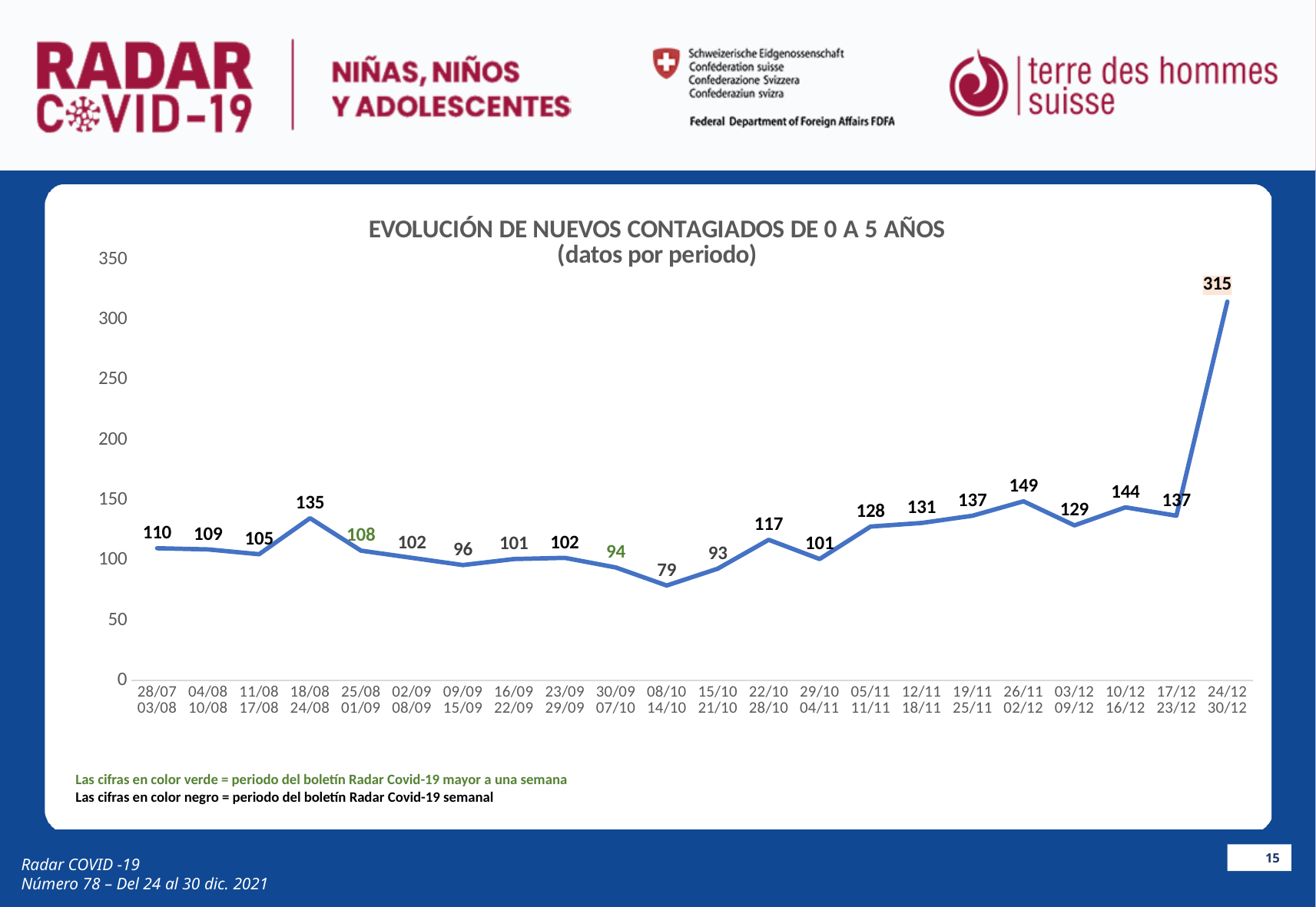
What is the value for the period 26/11–02/12? 149 What is the value for the period 24/12–30/12? 315 What is the title of the chart? EVOLUCIÓN DE NUEVOS CONTAGIADOS DE 0 A 5 AÑOS (datos por periodo) Which period has the lowest value? 08/10–14/10 How many periods are plotted on the x axis? 22 Which values are shown in green on the chart? 108 and 94 Which is larger, the value for 22/10–28/10 or the value for 29/10–04/11? 22/10–28/10 What is the difference between the values for 24/12–30/12 and 17/12–23/12? 178 What type of chart is shown on the slide? line chart What is the value for the period 18/08–24/08? 135 What is the value for the period 08/10–14/10? 79 Which period has the highest value? 24/12–30/12